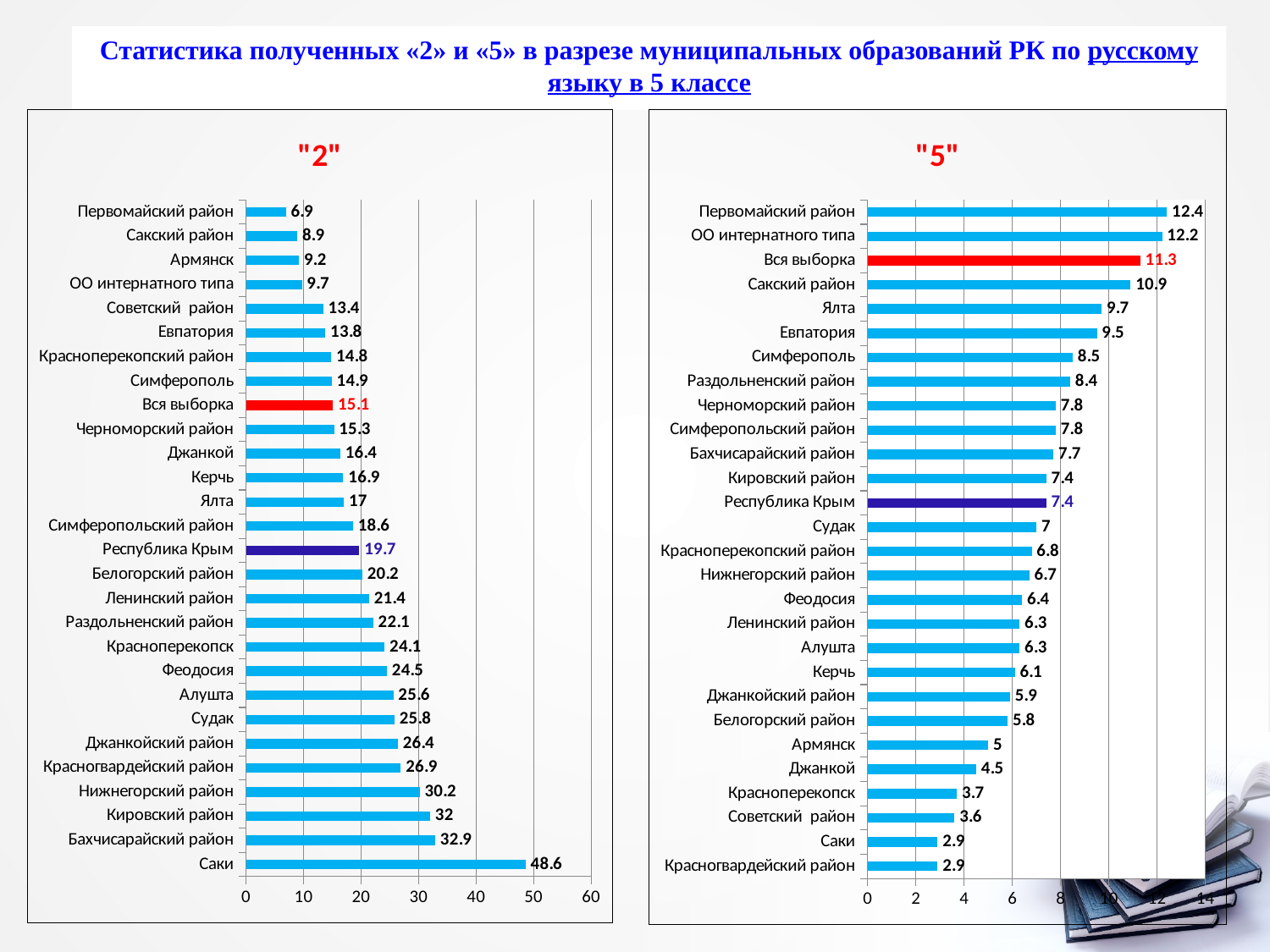
In the "5" chart, which is larger, the value for Евпатория or the value for Симферополь? Евпатория In the "2" chart, which category has the lowest value? Первомайский район In the "5" chart, which category has the highest value? Первомайский район In the "2" chart, is the value for Нижнегорский район greater or less than 20? greater What type of chart is the "2" chart? bar chart In the "2" chart, what is the difference between the values for Бахчисарайский район and Кировский район? 0.9 In the "5" chart, what is the value for Ялта? 9.7 In the "2" chart, which category has the highest value? Саки In the "5" chart, what is the value for Вся выборка? 11.3 In the "2" chart, what is the value for Саки? 48.6 In the "2" chart, what is the value for Республика Крым? 19.7 How many categories are shown in the "5" chart? 28